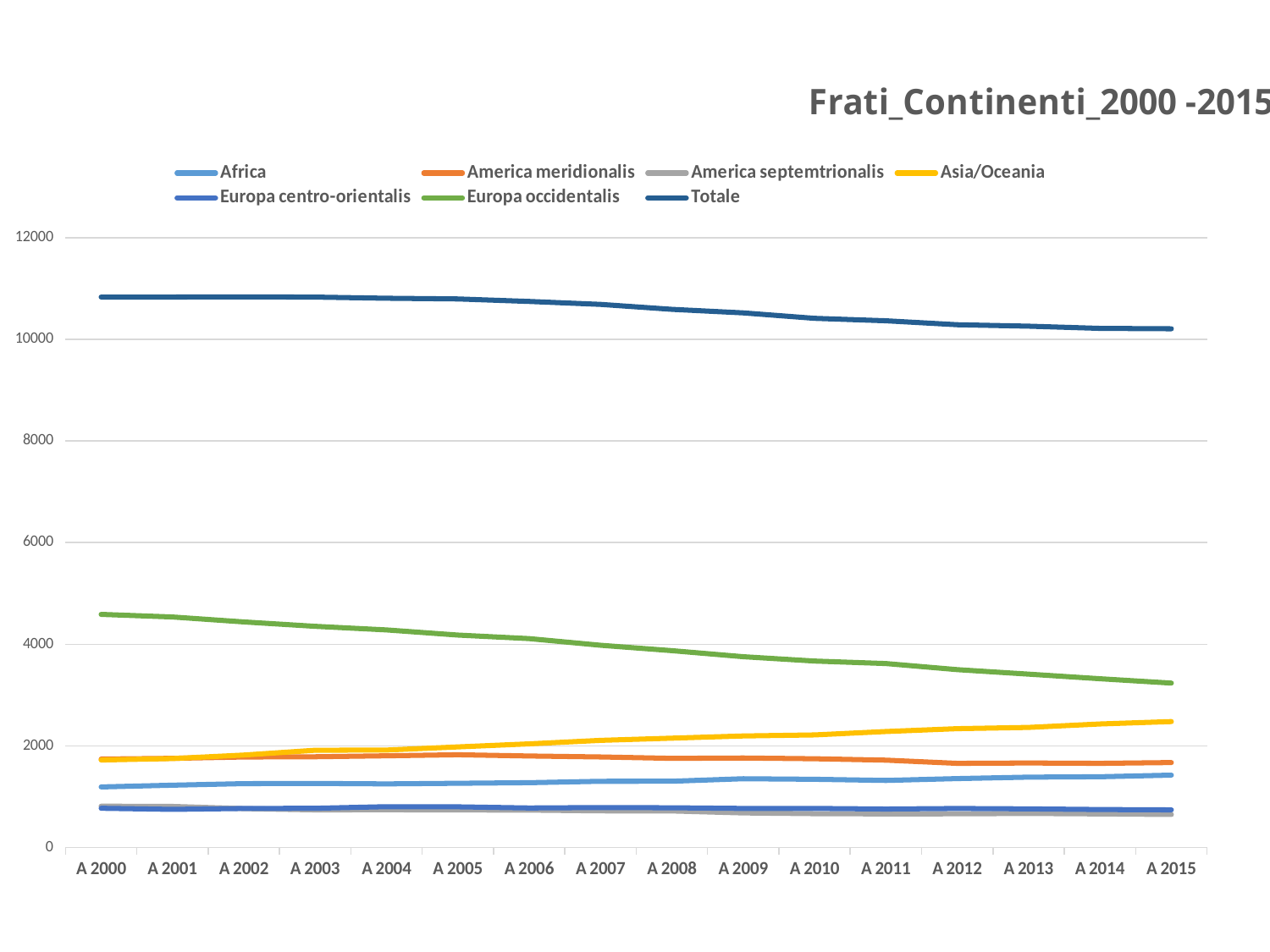
Is the value for Asia/Oceania in A 2015 greater or less than 2000? greater Is the value for Europa occidentalis in A 2015 greater or less than 4000? less How many series does the legend list? 7 What kind of chart is shown on the slide? line chart What is the title of the chart? Frati_Continenti_2000 -2015 Does the Europa occidentalis line rise or fall from A 2000 to A 2015? fall How many years are shown along the x axis? 16 Which series has the highest value in A 2015? Totale Is the value for Totale in A 2000 greater or less than 10000? greater Does the Asia/Oceania line rise or fall from A 2000 to A 2015? rise Does the Totale line rise or fall from A 2000 to A 2015? fall In A 2015, which is larger: Europa occidentalis or Asia/Oceania? Europa occidentalis